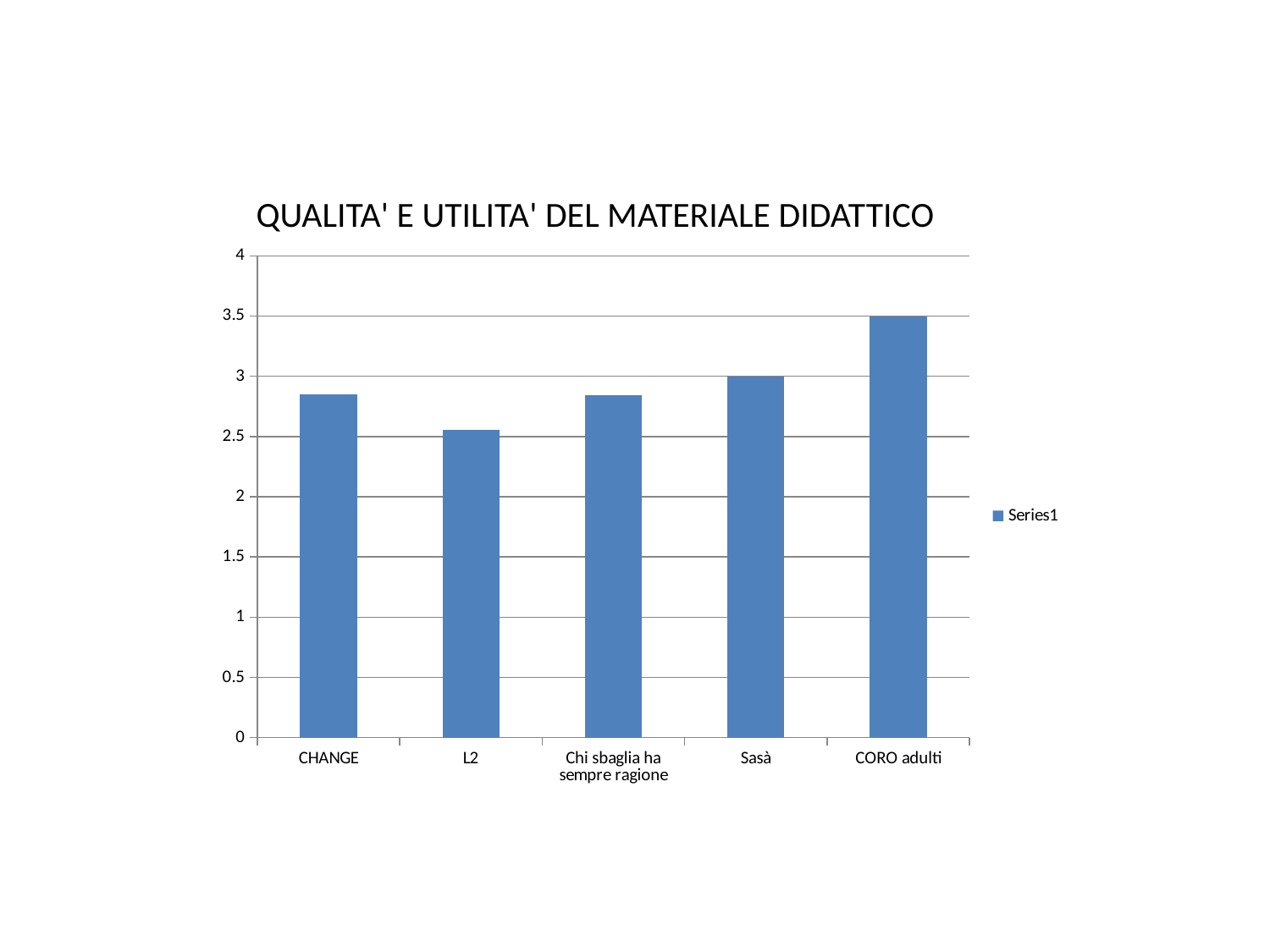
Is the value for Chi sbaglia ha sempre ragione greater or less than 3? less What is the title of the chart? QUALITA' E UTILITA' DEL MATERIALE DIDATTICO How many categories are shown on the x axis? 5 Which category has the lowest value? L2 How many series does the legend list? 1 What type of chart is shown on the slide? bar chart What is the value for Sasà? 3 What is the value for CORO adulti? 3.5 Which category has the highest value? CORO adulti What is the name of the series shown in the legend? Series1 What is the difference between the values for CORO adulti and Sasà? 0.5 Which is larger, the value for CHANGE or the value for L2? CHANGE